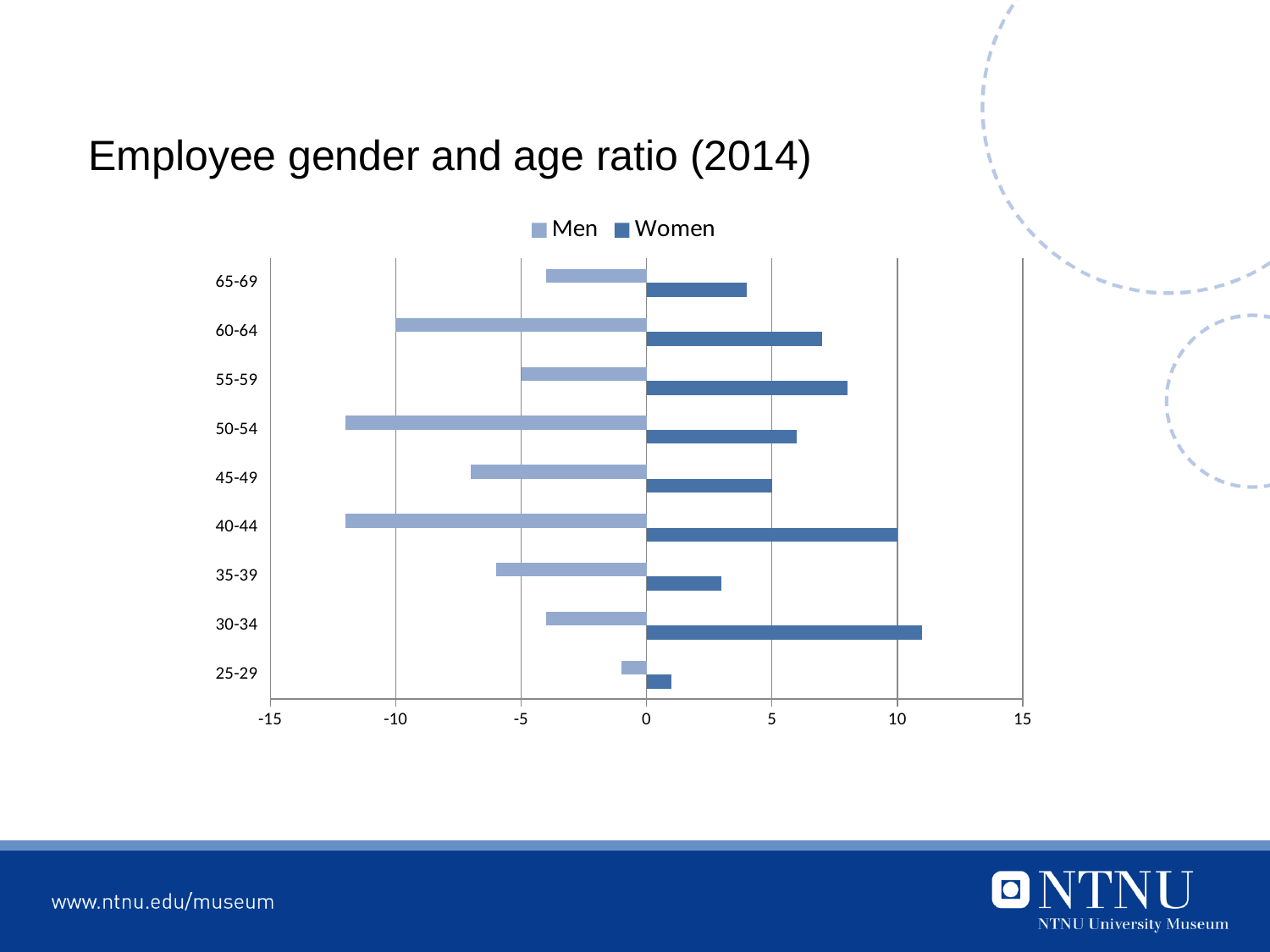
Which age group has the shortest Men bar? 25-29 How many series does the legend list? 2 Which is larger for Women: the 30-34 age group or the 35-39 age group? 30-34 Which age group has the highest value for Women? 30-34 Which is larger for Women: the 50-54 age group or the 45-49 age group? 50-54 How many age groups are shown on the chart? 9 Is the value for Men in the 50-54 age group greater or less than -10? less Is the value for Women in the 35-39 age group greater or less than 5? less Which age group has the lowest value for Women? 25-29 Is the value for Women in the 55-59 age group greater or less than 5? greater What is the title of the chart on the slide? Employee gender and age ratio (2014) What kind of chart is shown on the slide? bar chart